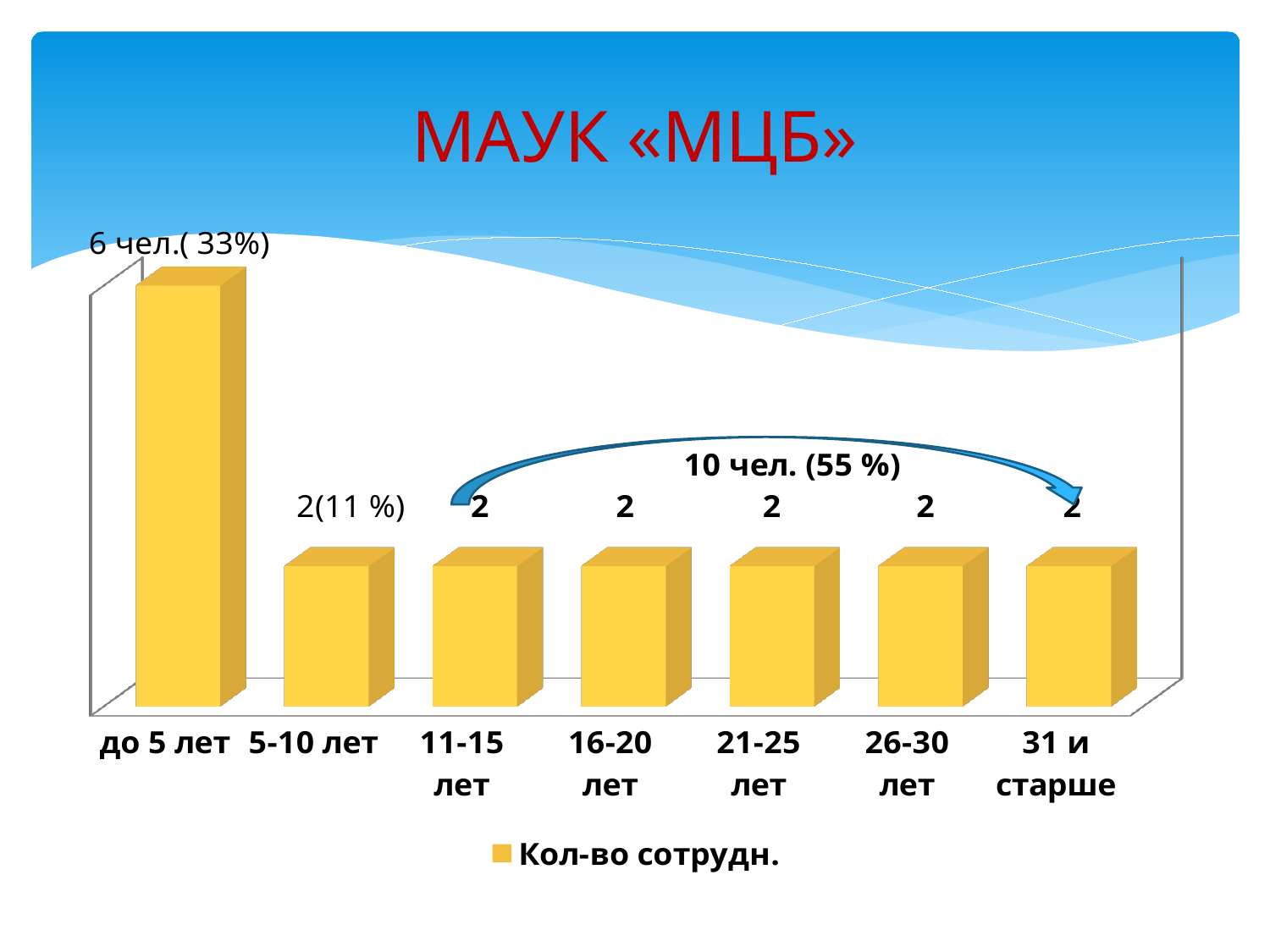
How many categories are shown on the x axis? 7 What is the value for the category '16-20 лет'? 2 What is the name of the series in the legend? Кол-во сотрудн. What is the difference between the values for 'до 5 лет' and '5-10 лет'? 4 What is the value for the category 'до 5 лет'? 6 Which category has the highest value? до 5 лет What kind of chart is shown on the slide? bar chart Which is larger, the value for 'до 5 лет' or the value for '21-25 лет'? до 5 лет What is the value for the category '31 и старше'? 2 What percentage share is printed next to the bar for 'до 5 лет'? 33% How many series does the legend list? 1 What is the total number of people indicated for the categories from '11-15 лет' to '31 и старше'? 10 чел. (55 %)